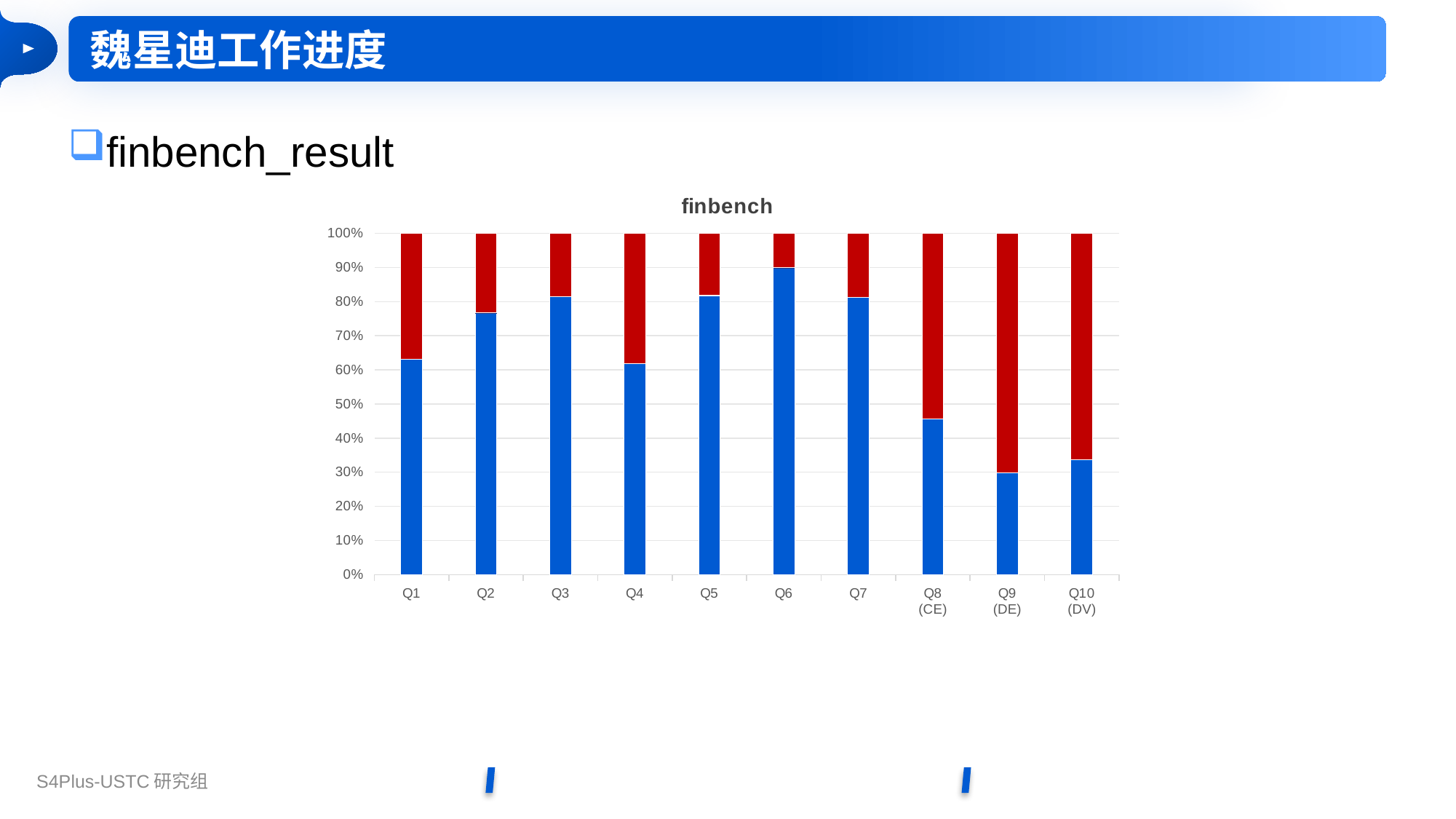
What kind of chart is shown on the slide? Stacked bar chart How many categories are shown on the x axis of the chart? 10 Is the blue segment for Q8 (CE) greater or less than 50%? less What is the total height of the stacked bar for Q1? 100% Which category has the largest red segment? Q9 (DE) Which has the larger blue segment, Q8 (CE) or Q10 (DV)? Q8 (CE) Which category has the smallest blue segment? Q9 (DE) Is the blue segment for Q1 greater or less than 60%? greater What is the title of the chart? finbench Which has the larger blue segment, Q3 or Q4? Q3 Is the blue segment for Q6 greater or less than 80%? greater Which category has the largest blue segment? Q6